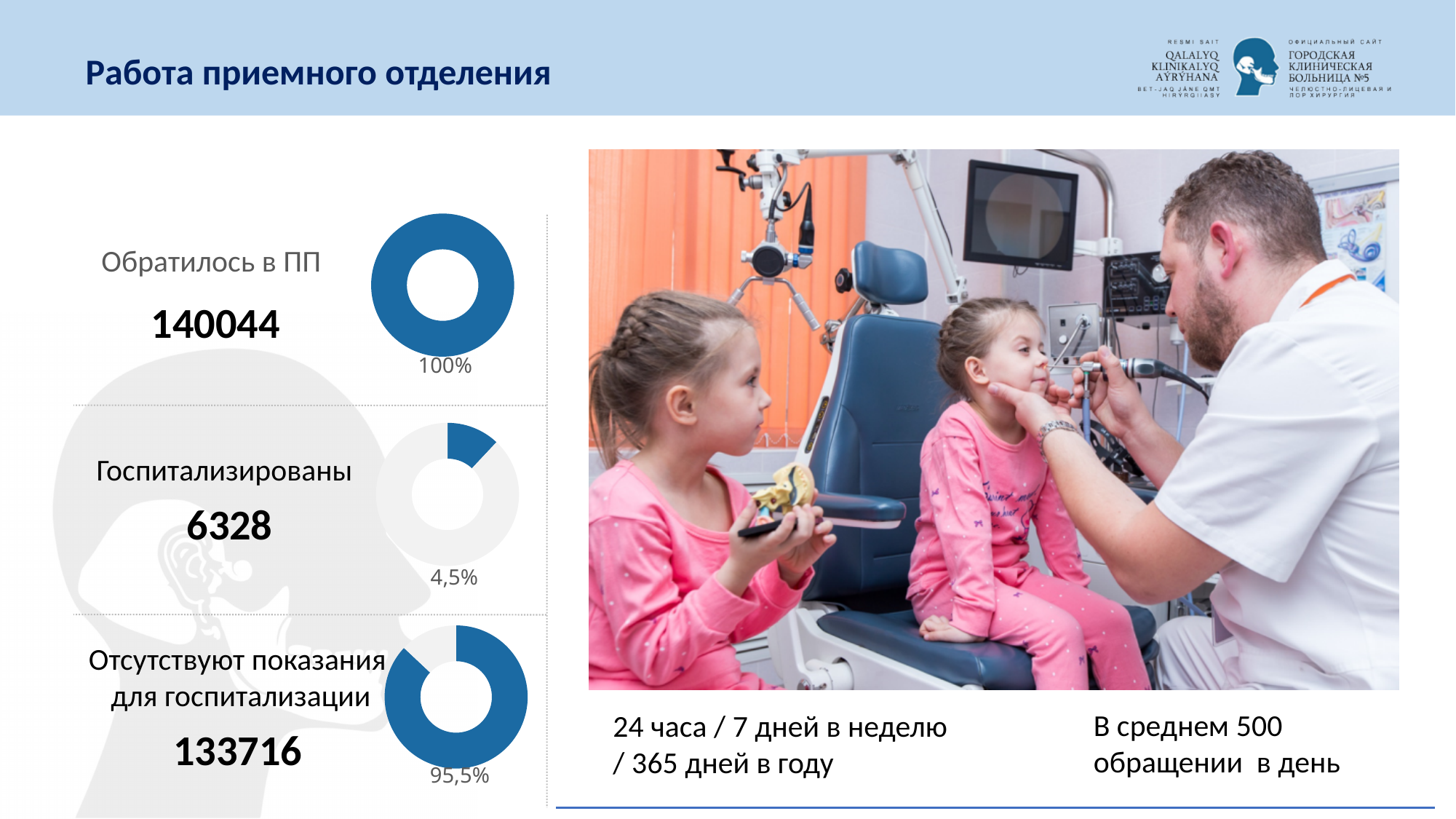
What percentage is shown under the bottom donut chart labelled "Отсутствуют показания для госпитализации"? 95,5% What percentage is shown under the top donut chart labelled "Обратилось в ПП"? 100% Which is larger: the share for "Госпитализированы" or the share for "Отсутствуют показания для госпитализации"? Отсутствуют показания для госпитализации What number is shown for "Отсутствуют показания для госпитализации"? 133716 Which of the three donut charts shows the smallest percentage? Госпитализированы What kind of chart is used next to "Госпитализированы" on the slide? donut chart What number is shown for "Госпитализированы"? 6328 What is the difference between the number for "Отсутствуют показания для госпитализации" and the number for "Госпитализированы"? 127388 What percentage is shown under the middle donut chart labelled "Госпитализированы"? 4,5% What number is shown for "Обратилось в ПП"? 140044 How many donut charts are shown on the slide? 3 What is the title of the slide containing the donut charts? Работа приемного отделения